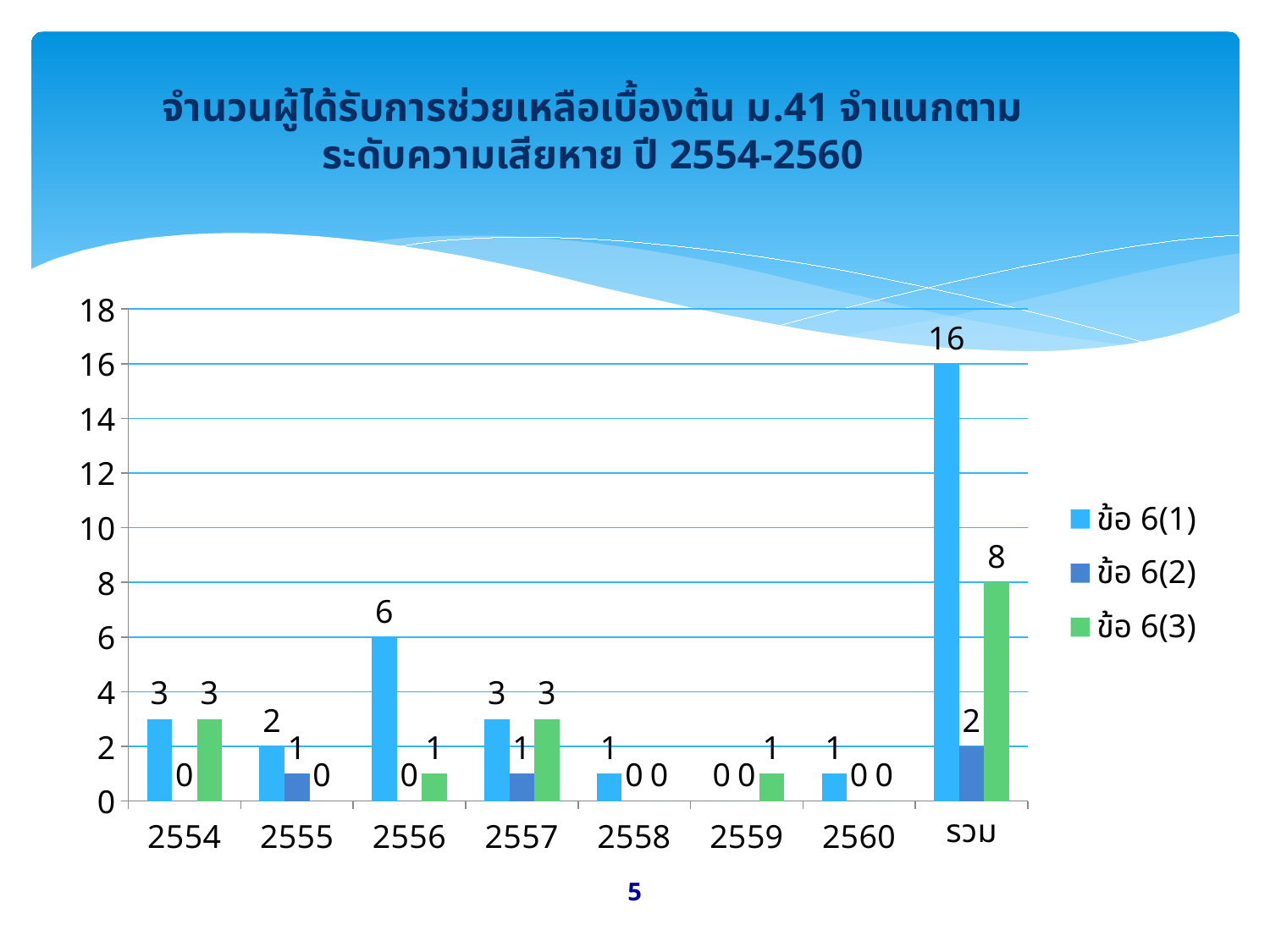
What is the value for ข้อ 6(1) in the รวม category? 16 What is the value for ข้อ 6(1) in 2556? 6 What is the value for ข้อ 6(2) in 2555? 1 Among the years 2554 to 2560, which year has the highest value for ข้อ 6(1)? 2556 What is the difference between the ข้อ 6(1) and ข้อ 6(3) values in the รวม category? 8 Which is larger in 2557: the value for ข้อ 6(1) or the value for ข้อ 6(2)? ข้อ 6(1) How many series does the legend list? 3 What is the value for ข้อ 6(3) in the รวม category? 8 What kind of chart is shown on the slide? bar chart Among the years 2554 to 2560, which year has the lowest value for ข้อ 6(1)? 2559 How many categories are shown on the x axis? 8 What is the total of the three series values in 2554? 6